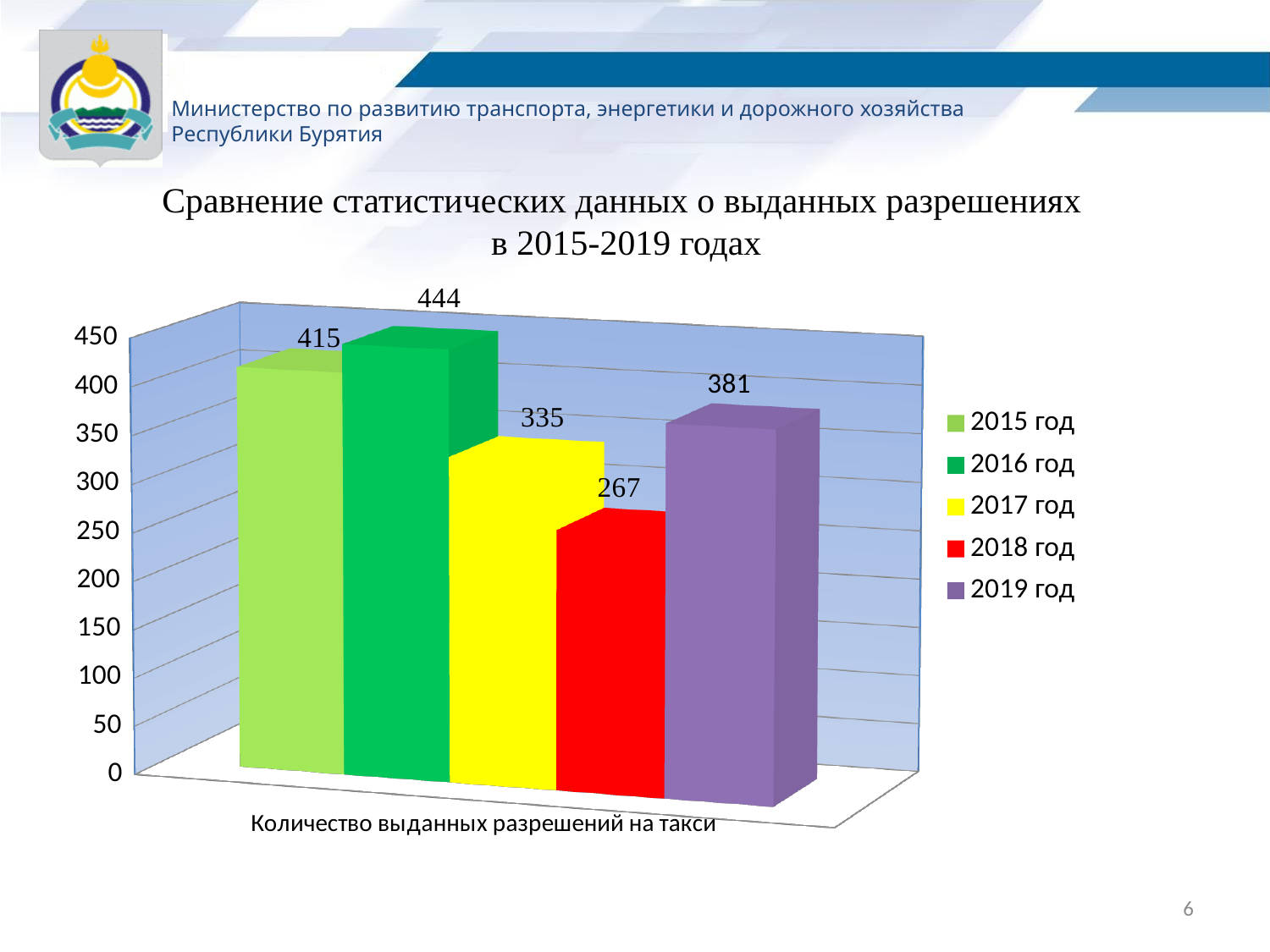
What is the value for 2019 год? 381 Is the value for 2017 год greater or less than 300? greater What is the value for 2015 год? 415 Which year has the lowest number of issued taxi permits? 2018 год What colour is the bar for 2018 год? red What is the value for 2018 год? 267 How many series does the legend list? 5 Which year has the highest number of issued taxi permits? 2016 год What kind of chart is shown on the slide? bar chart What is the difference between the values for 2016 год and 2015 год? 29 What is the difference between the values for 2019 год and 2018 год? 114 Which is larger, the value for 2017 год or the value for 2019 год? 2019 год